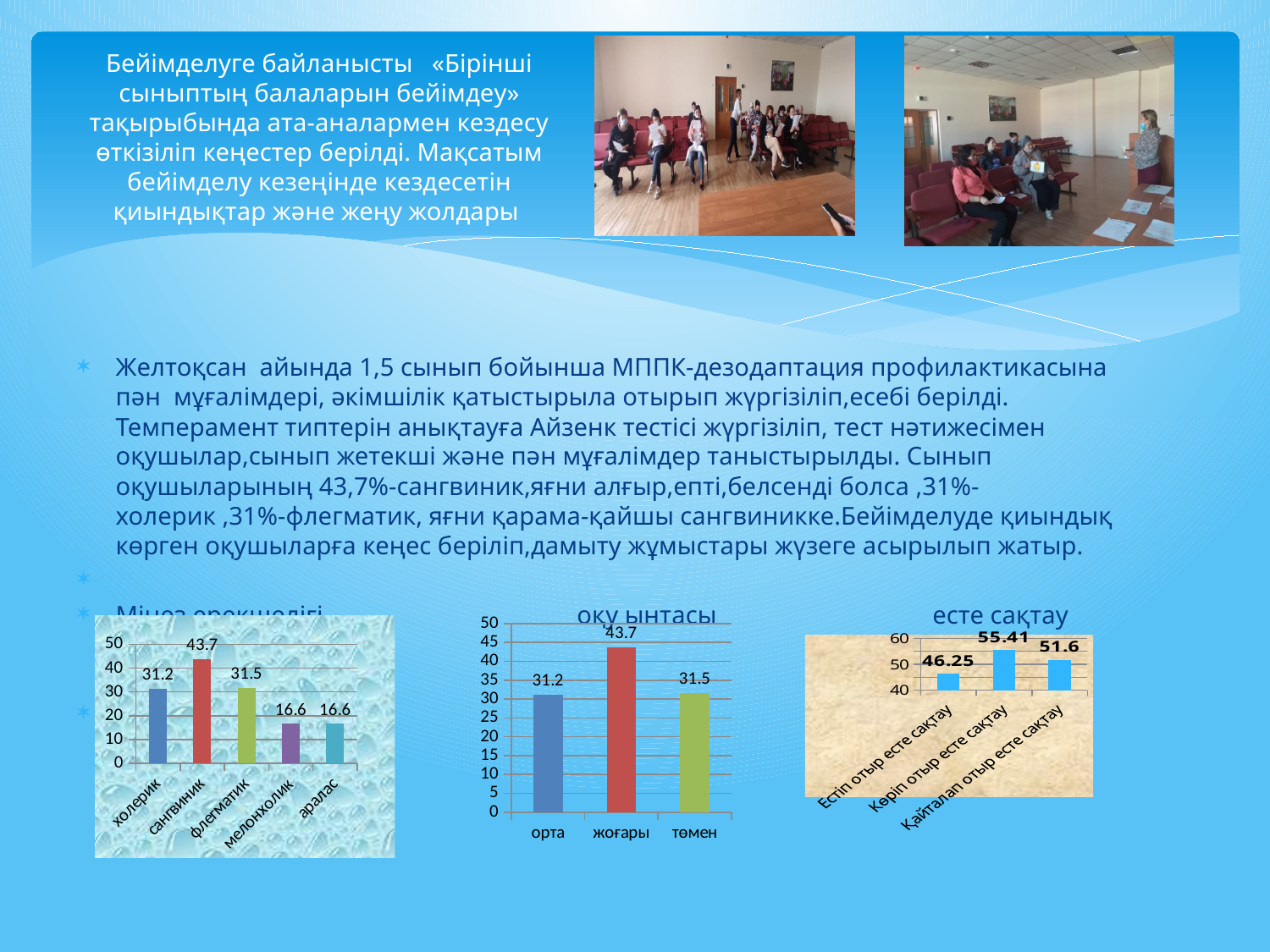
In the chart titled 'оқу ынтасы', what kind of chart is shown? bar chart In the left chart, how many categories are shown? 5 In the chart titled 'есте сақтау', which category has the lowest value? Естіп отыр есте сақтау In the chart titled 'оқу ынтасы', which category has the lowest value? орта In the left chart, what is the difference between the values for сангвиник and холерик? 12.5 In the chart titled 'оқу ынтасы', how many categories are shown? 3 In the chart titled 'оқу ынтасы', what is the value for жоғары? 43.7 In the chart titled 'есте сақтау', what is the value for Көріп отыр есте сақтау? 55.41 In the chart titled 'есте сақтау', what is the difference between the values for Көріп отыр есте сақтау and Естіп отыр есте сақтау? 9.16 In the left chart, what is the value for сангвиник? 43.7 In the left chart, which category has the highest value? сангвиник In the left chart, what is the value for мелонхолик? 16.6